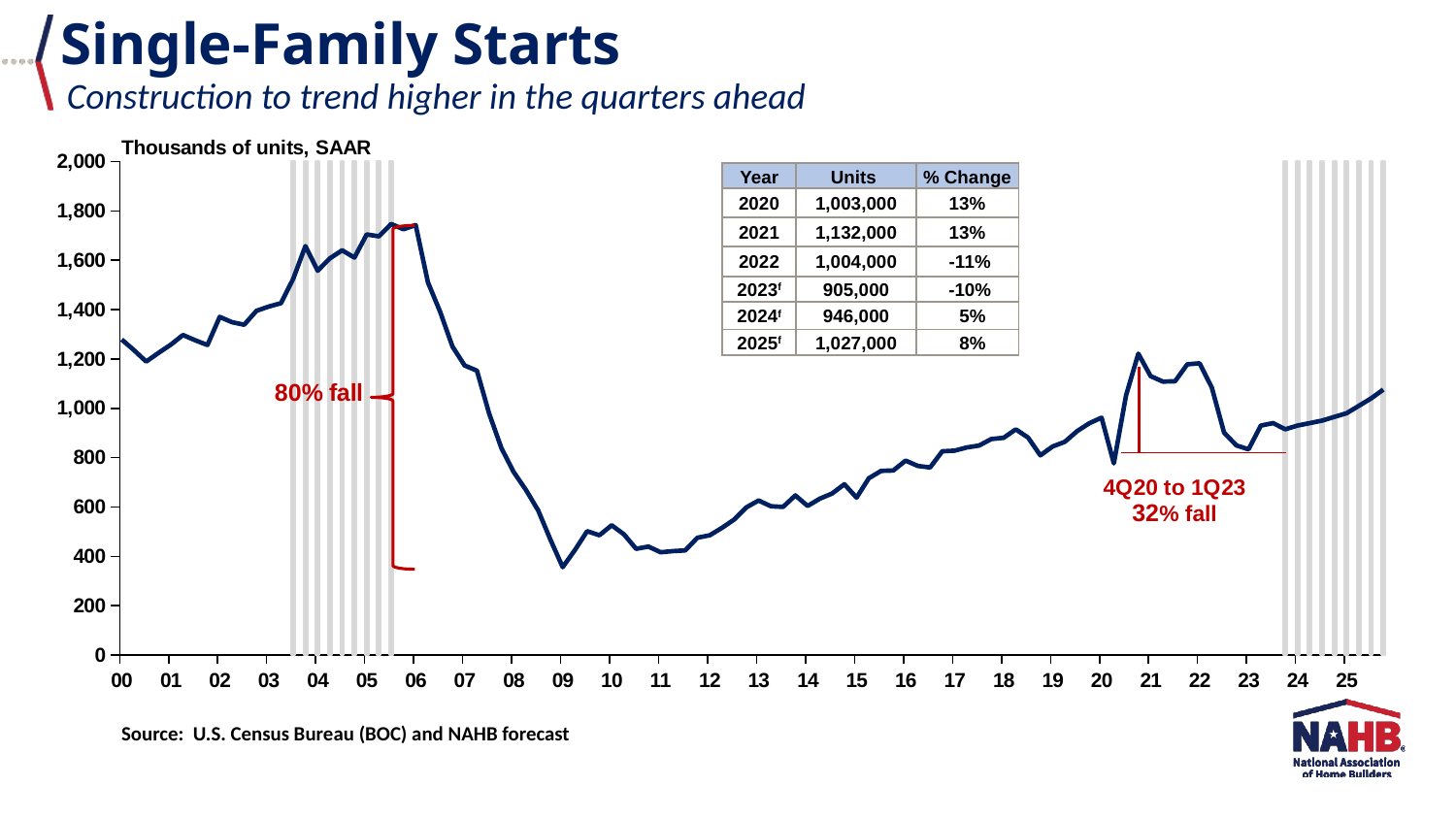
What unit label is shown above the y axis of the chart? Thousands of units, SAAR Does the line generally rise or fall between 2009 and 2020? rise What kind of chart is shown on the slide? line chart According to the table on the chart, how many units were started in 2021? 1,132,000 What is the difference in units between 2021 and 2020 in the table? 129,000 According to the table on the chart, what is the forecast number of units for 2025? 1,027,000 According to the table on the chart, what is the % change for 2022? -11% Which year in the table has the highest number of units? 2021 What is the title of the chart on the slide? Single-Family Starts Is the value of the line at the 2009 trough greater or less than 400? less Is the value of the line at its 2005-06 peak greater or less than 1,600? greater Which year in the table has the lowest number of units? 2023